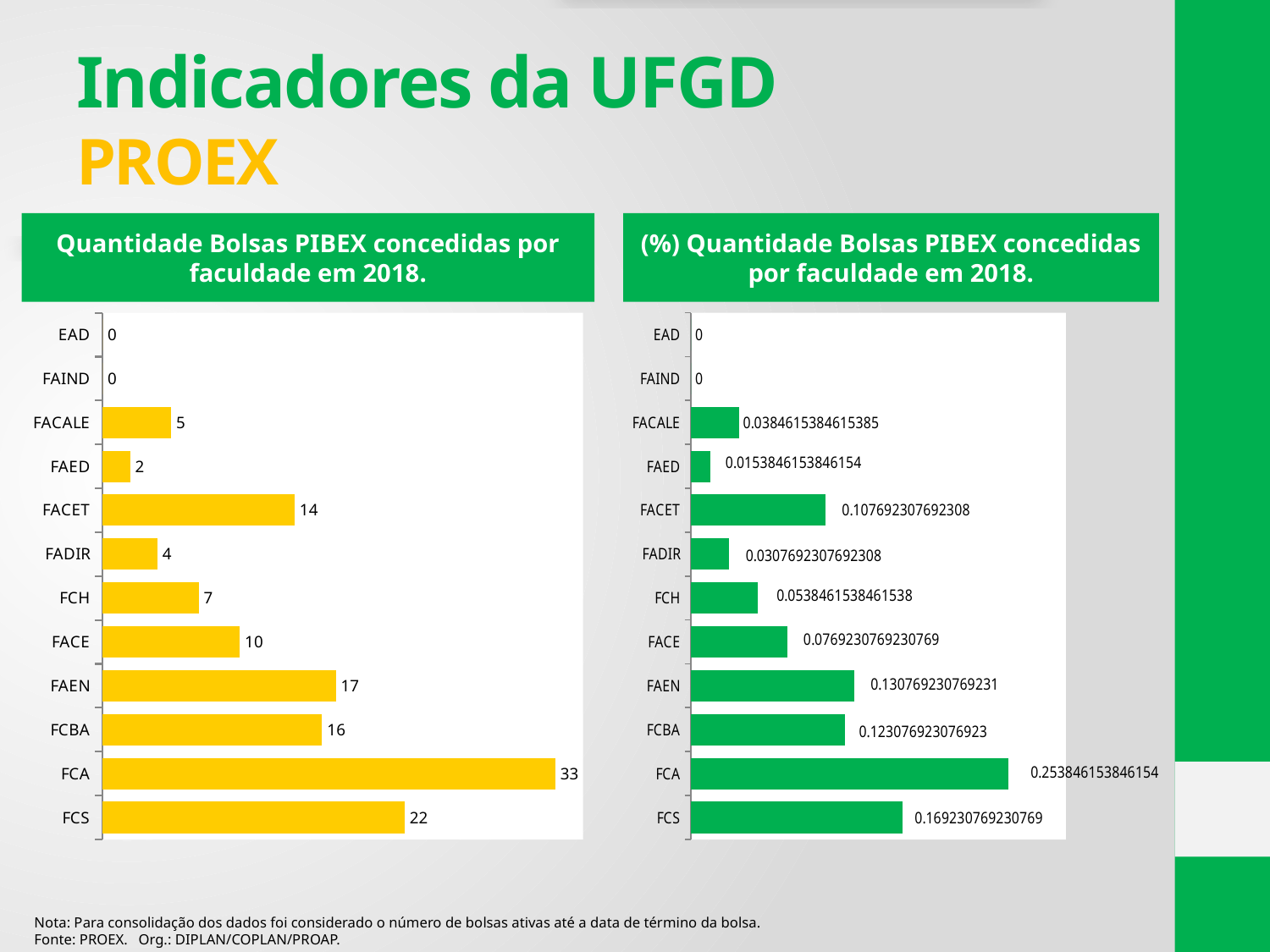
What colour are the bars in the chart 'Quantidade Bolsas PIBEX concedidas por faculdade em 2018.'? Yellow In the chart 'Quantidade Bolsas PIBEX concedidas por faculdade em 2018.', how many faculties are listed? 12 In the chart 'Quantidade Bolsas PIBEX concedidas por faculdade em 2018.', how many faculties have a value of 0? 2 In the chart '(%) Quantidade Bolsas PIBEX concedidas por faculdade em 2018.', which is larger, FACET or FACE? FACET What kind of chart is '(%) Quantidade Bolsas PIBEX concedidas por faculdade em 2018.'? Bar chart In the chart 'Quantidade Bolsas PIBEX concedidas por faculdade em 2018.', which faculty has the highest value? FCA In the chart '(%) Quantidade Bolsas PIBEX concedidas por faculdade em 2018.', what is the value for FAED? 0.0153846153846154 In the chart 'Quantidade Bolsas PIBEX concedidas por faculdade em 2018.', which is larger, FAEN or FCBA? FAEN In the chart 'Quantidade Bolsas PIBEX concedidas por faculdade em 2018.', what is the value for FACET? 14 In the chart '(%) Quantidade Bolsas PIBEX concedidas por faculdade em 2018.', what is the value for FCA? 0.253846153846154 In the chart 'Quantidade Bolsas PIBEX concedidas por faculdade em 2018.', what is the difference between FCA and FCS? 11 In the chart 'Quantidade Bolsas PIBEX concedidas por faculdade em 2018.', what is the value for FCA? 33